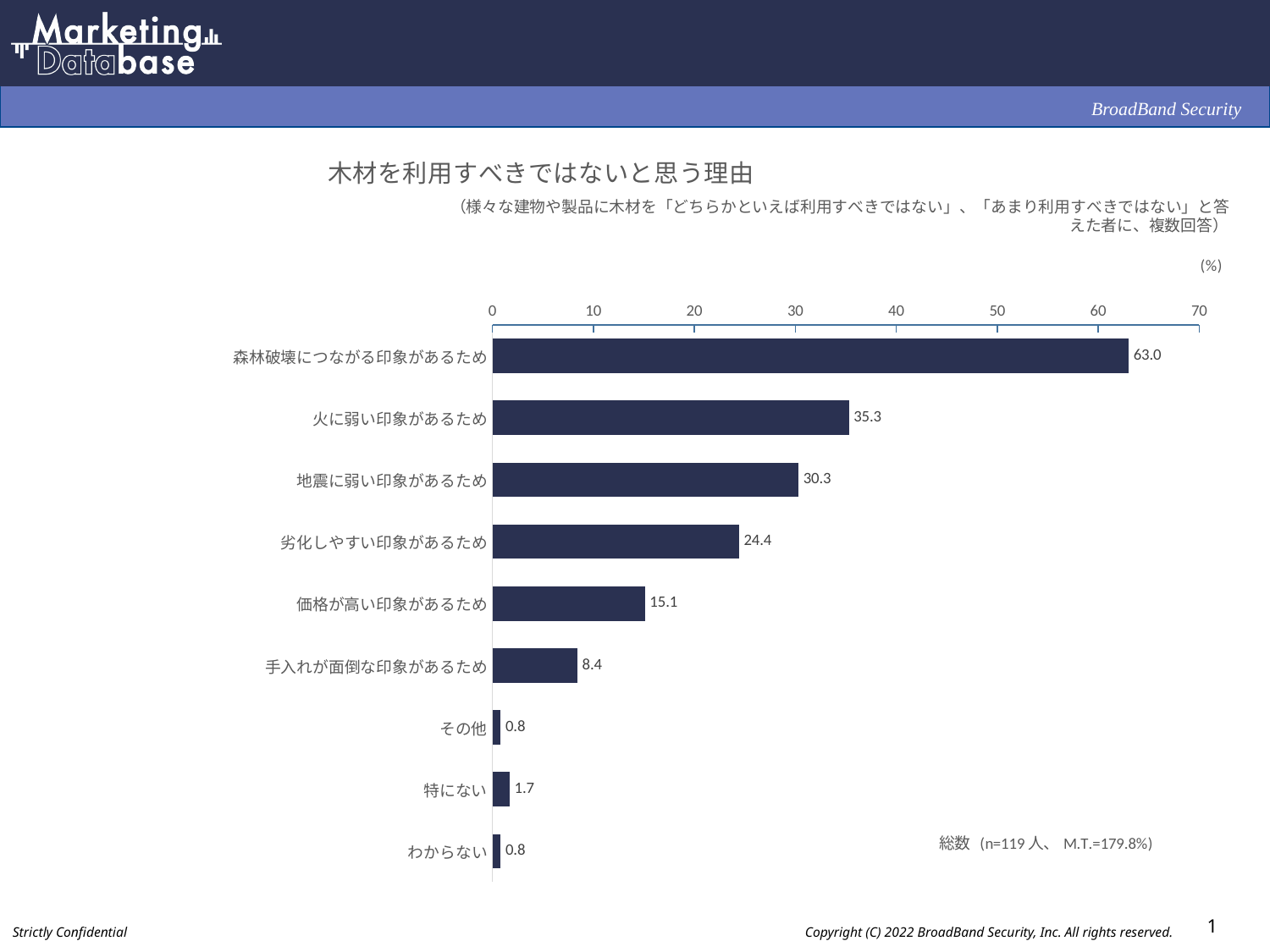
Is the value for 地震に弱い印象があるため greater or less than 20? greater What is the value for 森林破壊につながる印象があるため? 63.0 How many categories are shown in the chart? 9 Which is larger, the value for 価格が高い印象があるため or the value for 手入れが面倒な印象があるため? 価格が高い印象があるため What is the value for 特にない? 1.7 Which category has the highest value? 森林破壊につながる印象があるため What is the difference between the values for 森林破壊につながる印象があるため and 劣化しやすい印象があるため? 38.6 What kind of chart is shown on the slide? bar chart What is the value for 火に弱い印象があるため? 35.3 What is the difference between the values for 火に弱い印象があるため and 地震に弱い印象があるため? 5.0 What is the value for 手入れが面倒な印象があるため? 8.4 What is the title of the chart? 木材を利用すべきではないと思う理由